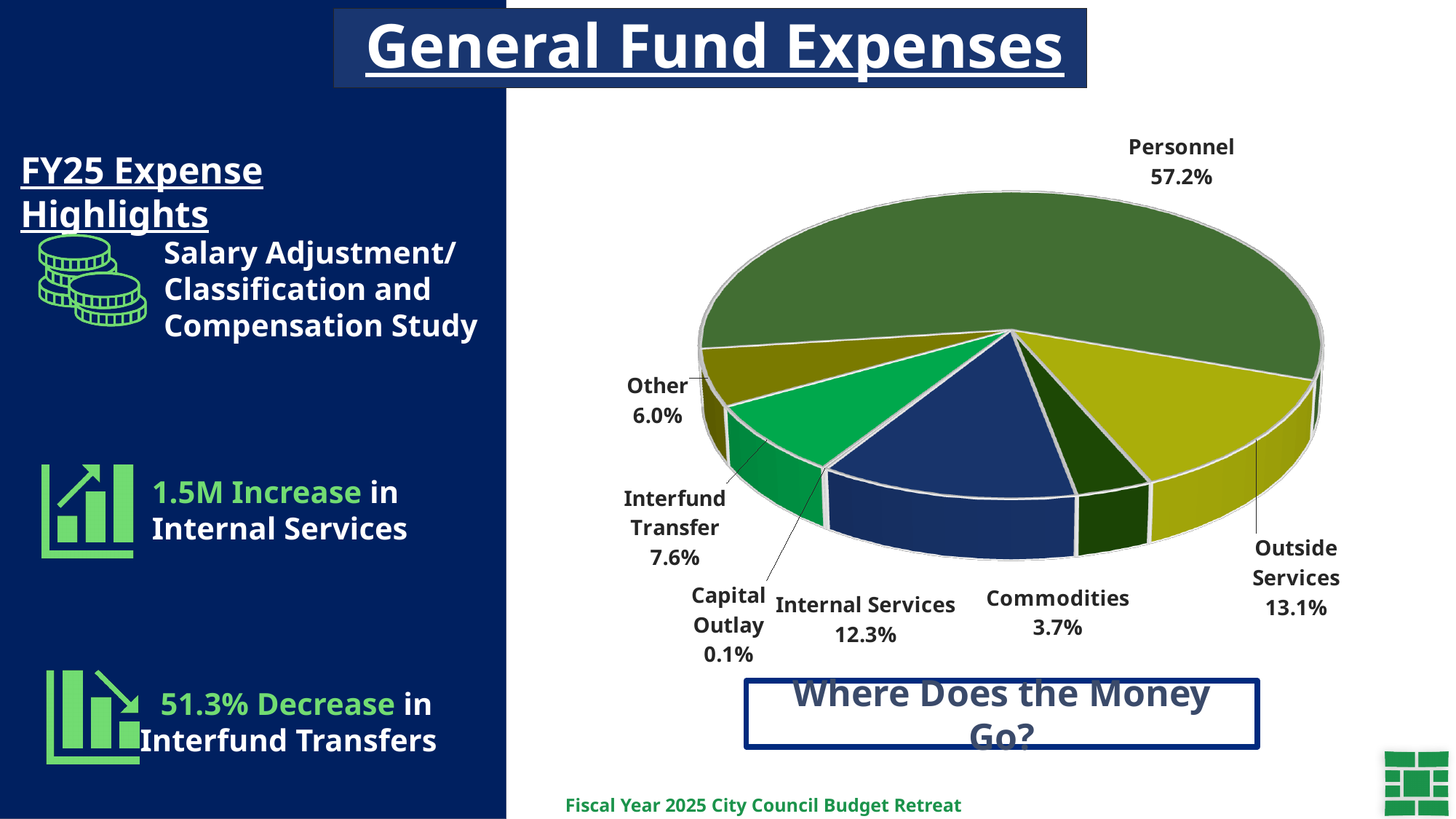
What share does Commodities represent? 3.7% What is the difference in percentage points between Personnel and Outside Services? 44.1 What kind of chart is shown on the slide? Pie chart Which category has the largest slice of the pie? Personnel Which is larger, Outside Services or Internal Services? Outside Services What is the title of the slide containing the pie chart? General Fund Expenses What is the value shown for Internal Services? 12.3% What percentage of the pie is Outside Services? 13.1% What share of General Fund Expenses goes to Personnel? 57.2% What percentage is labelled for Interfund Transfer? 7.6% How many categories are shown in the pie chart? 7 Which category has the smallest slice of the pie? Capital Outlay